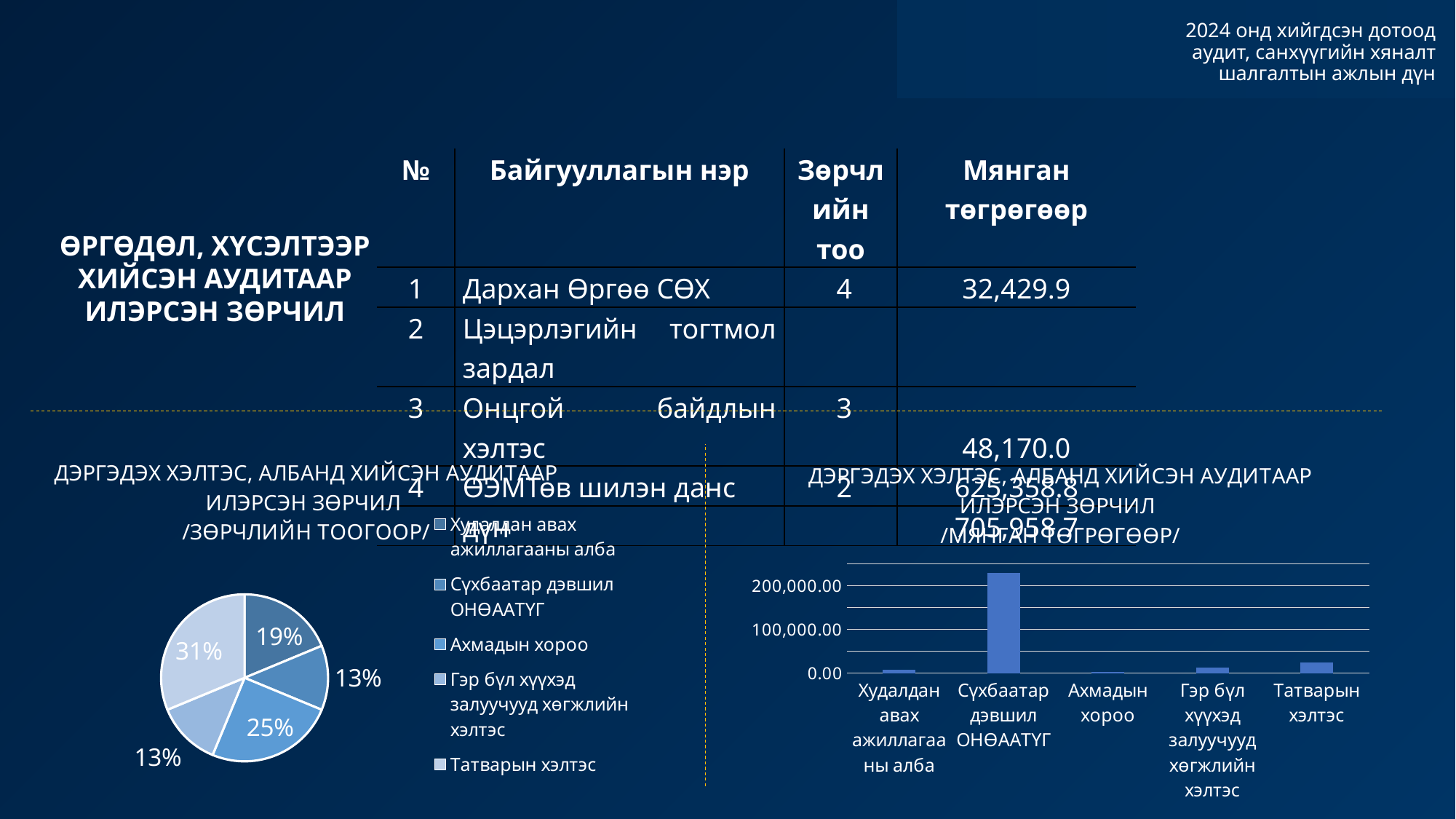
In the pie chart on the left, what share does Татварын хэлтэс have? 31% What kind of chart is the right chart (/МЯНГАН ТӨГРӨГӨӨР/)? bar chart In the bar chart on the right, is the value for Сүхбаатар дэвшил ОНӨААТҮГ greater or less than 200,000.00? greater In the bar chart on the right, which is larger: Татварын хэлтэс or Ахмадын хороо? Татварын хэлтэс How many categories are shown on the x axis of the bar chart on the right? 5 What is the largest percentage shown on the pie chart on the left? 31% How many slices does the pie chart on the left have? 5 In the bar chart on the right, is the value for Ахмадын хороо greater or less than 100,000.00? less How many slices of the pie chart on the left are labelled 13%? 2 In the pie chart on the left, what share does Худалдан авах ажиллагааны алба have? 19% In the bar chart on the right, which category has the highest value? Сүхбаатар дэвшил ОНӨААТҮГ What kind of chart is the left chart (/ЗӨРЧЛИЙН ТООГООР/)? pie chart